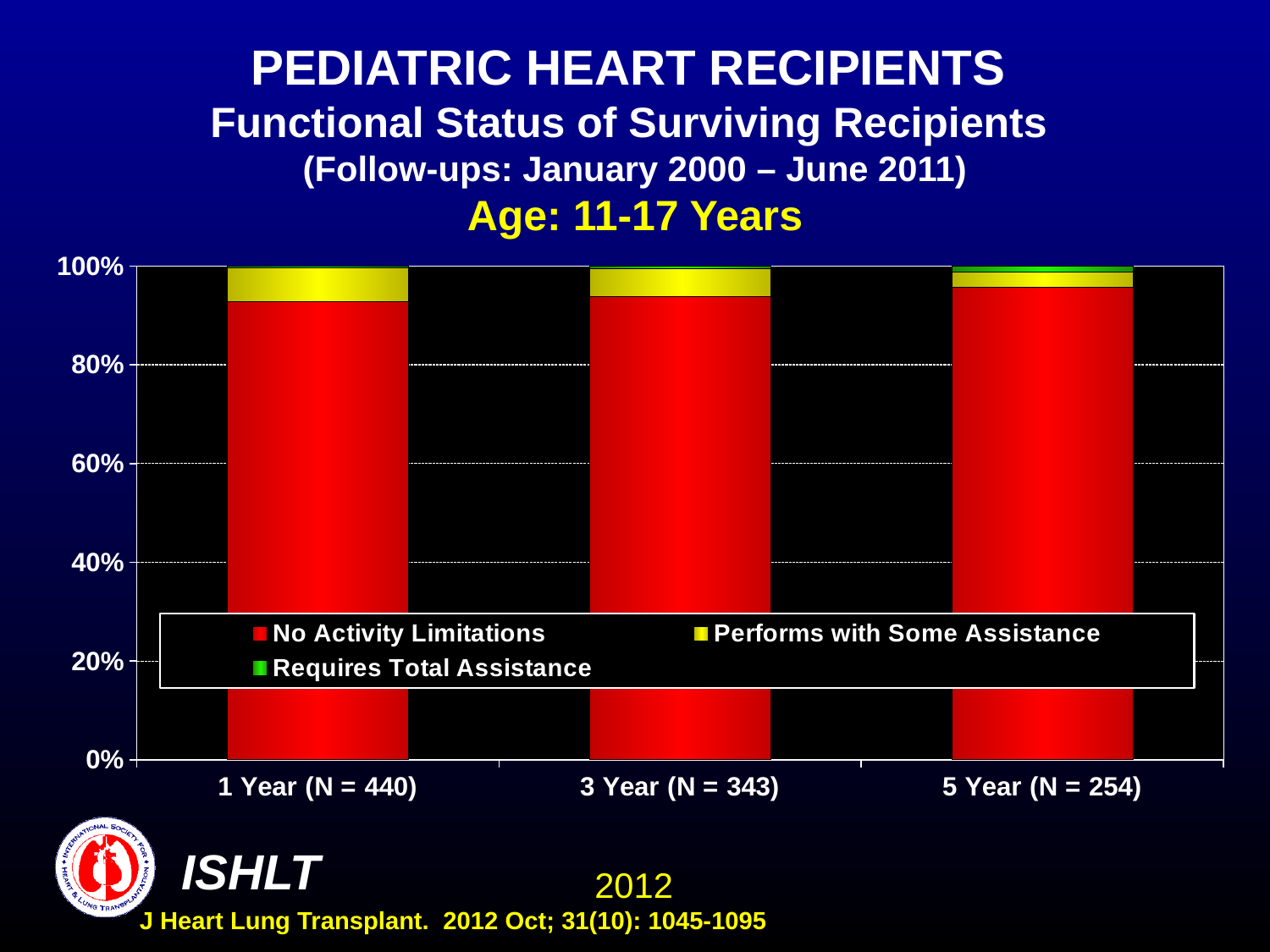
Which series makes up the largest part of each bar? No Activity Limitations What kind of chart is shown on the slide? stacked bar chart What is the N for the 5 Year category? 254 Is the value for No Activity Limitations at 5 Year greater or less than 60%? greater In which category is the Requires Total Assistance segment visible? 5 Year (N = 254) Is the value for No Activity Limitations at 1 Year greater or less than 80%? greater How many series does the legend list? 3 What is the age group shown in the chart title? 11-17 Years Is the value for Performs with Some Assistance at 3 Year greater or less than 20%? less How many categories are shown on the x axis? 3 Which is larger at 1 Year: No Activity Limitations or Performs with Some Assistance? No Activity Limitations